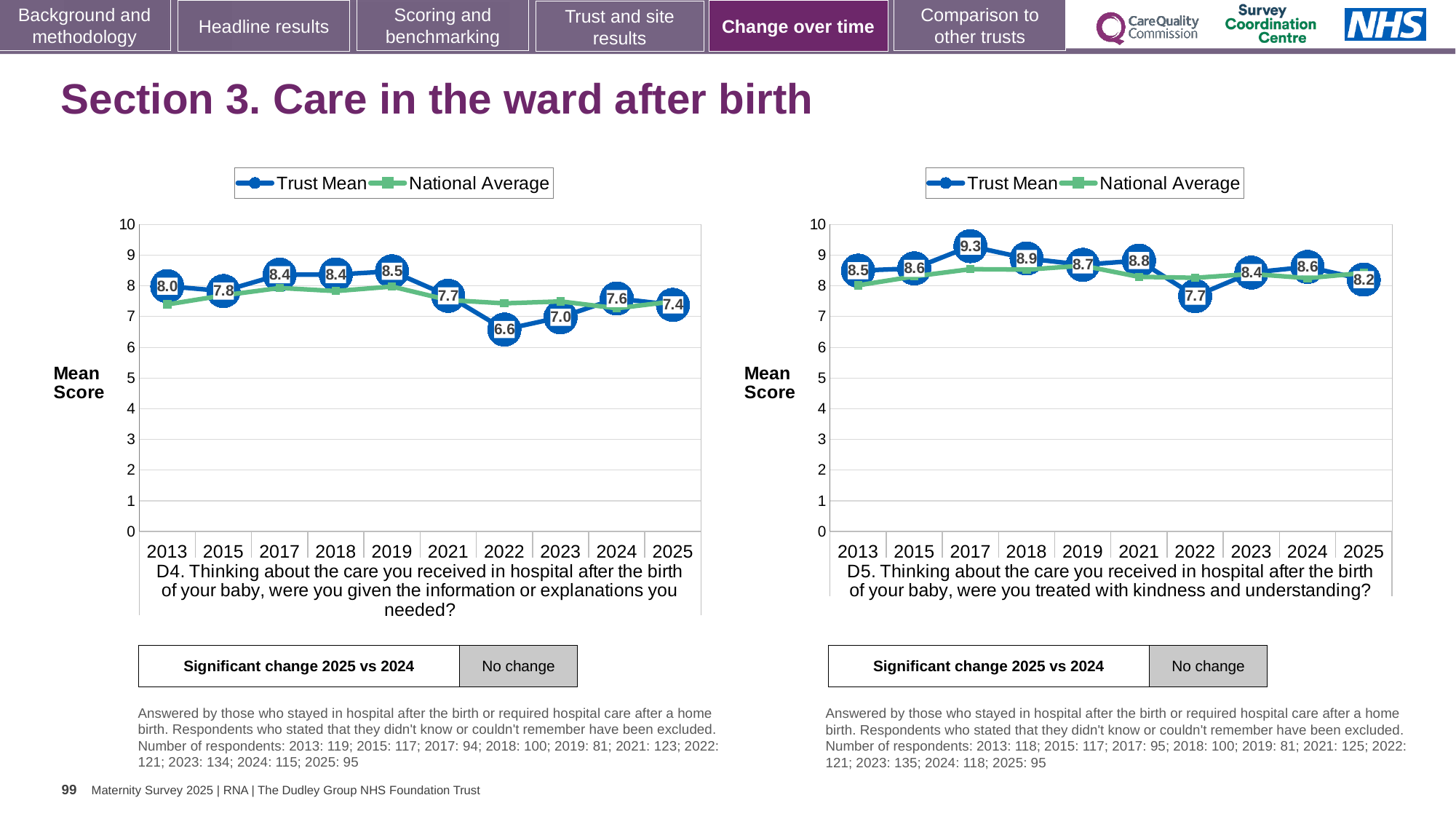
How many series does the legend of the D4 chart on the left list? 2 In the D5 chart on the right, which year has the lowest Trust Mean score? 2022 In the D5 chart on the right, which is larger: the Trust Mean score for 2018 or for 2025? 2018 In the D4 chart on the left, does the Trust Mean rise or fall from 2019 to 2022? Fall In the D4 chart on the left, which year has the highest Trust Mean score? 2019 What type of chart is the D5 chart on the right? Line chart In the D4 chart on the left, what is the Trust Mean score for 2022? 6.6 In the D4 chart on the left, is the National Average value for 2013 greater or less than 8? less In the D4 chart on the left, what is the difference between the Trust Mean scores for 2019 and 2022? 1.9 In the D5 chart on the right, what is the Trust Mean score for 2017? 9.3 How many years are shown on the x axis of the D5 chart on the right? 10 What is the y-axis label on the D4 chart on the left? Mean Score